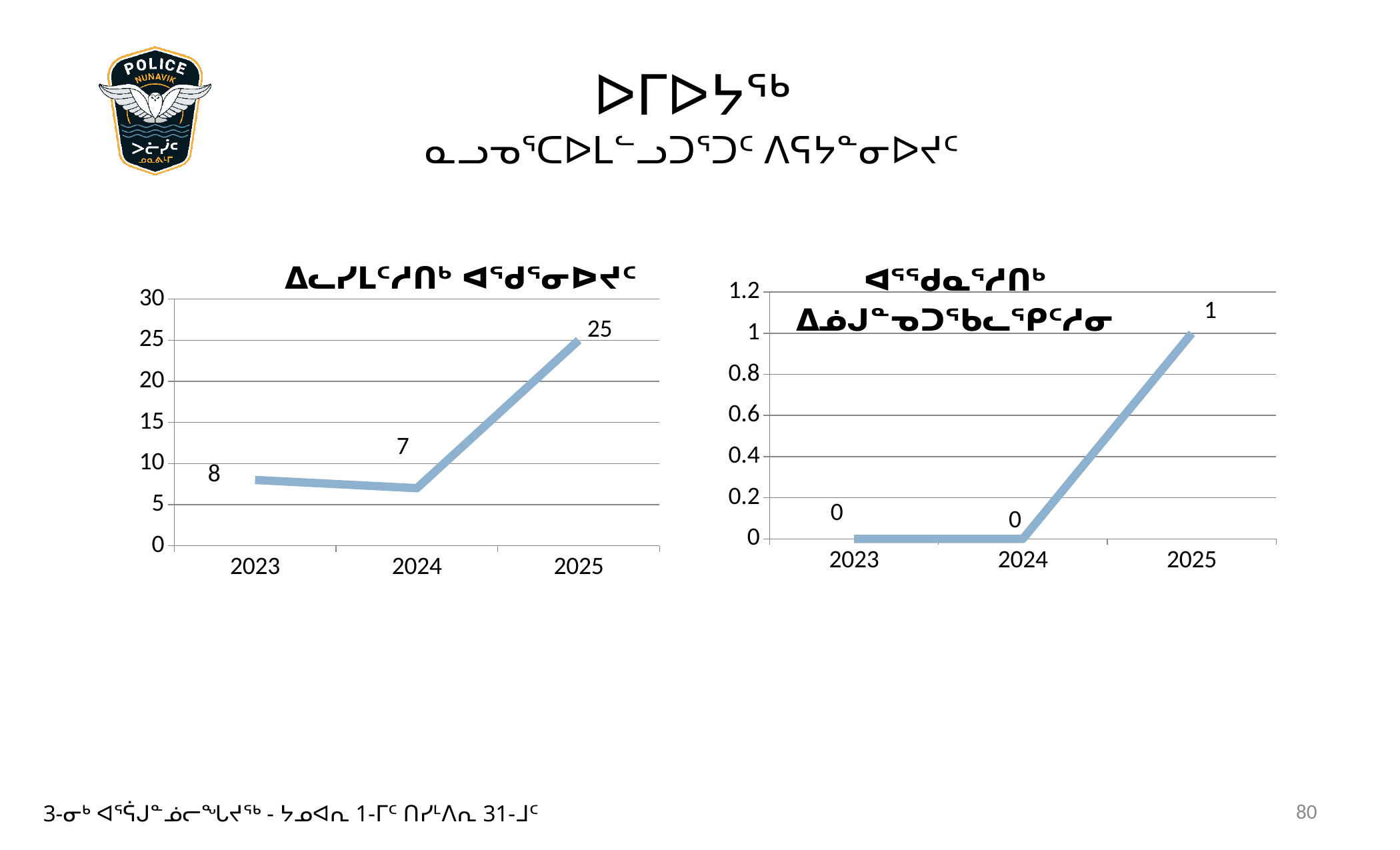
In the right chart, what is the value for 2023? 0 In the left chart, what is the difference between the values for 2025 and 2024? 18 In the left chart, which year has the lowest value? 2024 In the left chart, what is the value for 2023? 8 In the left chart, which year has the highest value? 2025 In the left chart, what is the value for 2024? 7 How many years are plotted on the x axis of the left chart? 3 In the left chart, what is the value for 2025? 25 In the right chart, which year has the highest value? 2025 In the right chart, what is the value for 2025? 1 What type of chart is the right chart? line chart In the left chart, is the value for 2023 greater or less than 10? less